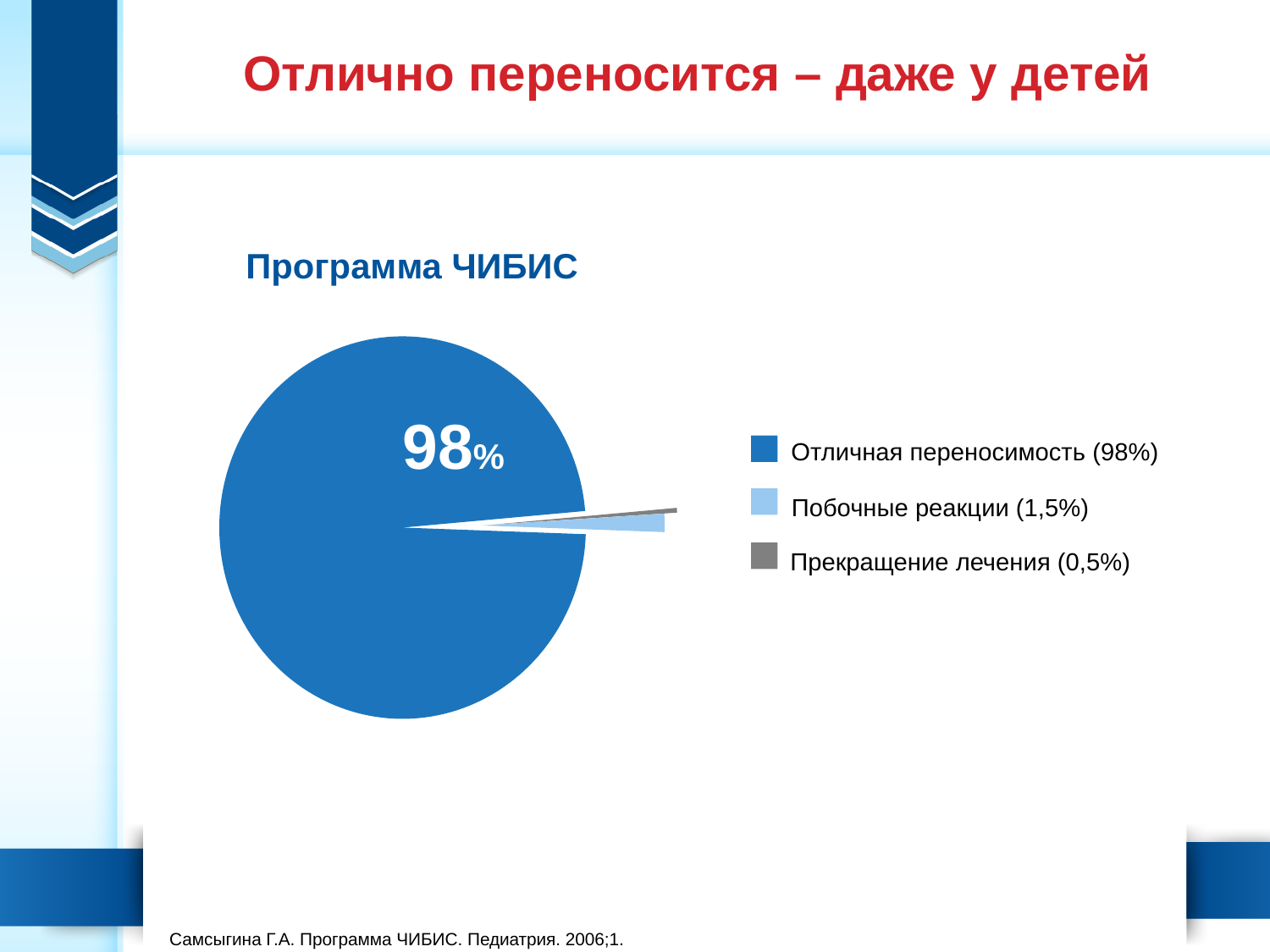
What is the value for "Прекращение лечения"? 0,5% What colour is the slice for "Прекращение лечения"? grey How many entries does the legend list? 3 What share of the pie does "Отличная переносимость" take? 98% Which category has the smallest slice of the pie? Прекращение лечения What is the value for "Побочные реакции"? 1,5% Which category has the largest slice of the pie? Отличная переносимость Which is larger, "Побочные реакции" or "Прекращение лечения"? Побочные реакции What is the difference between the values for "Побочные реакции" and "Прекращение лечения"? 1% How many categories does the pie chart have? 3 What is the title shown above the pie chart? Программа ЧИБИС What kind of chart is shown on the slide? pie chart